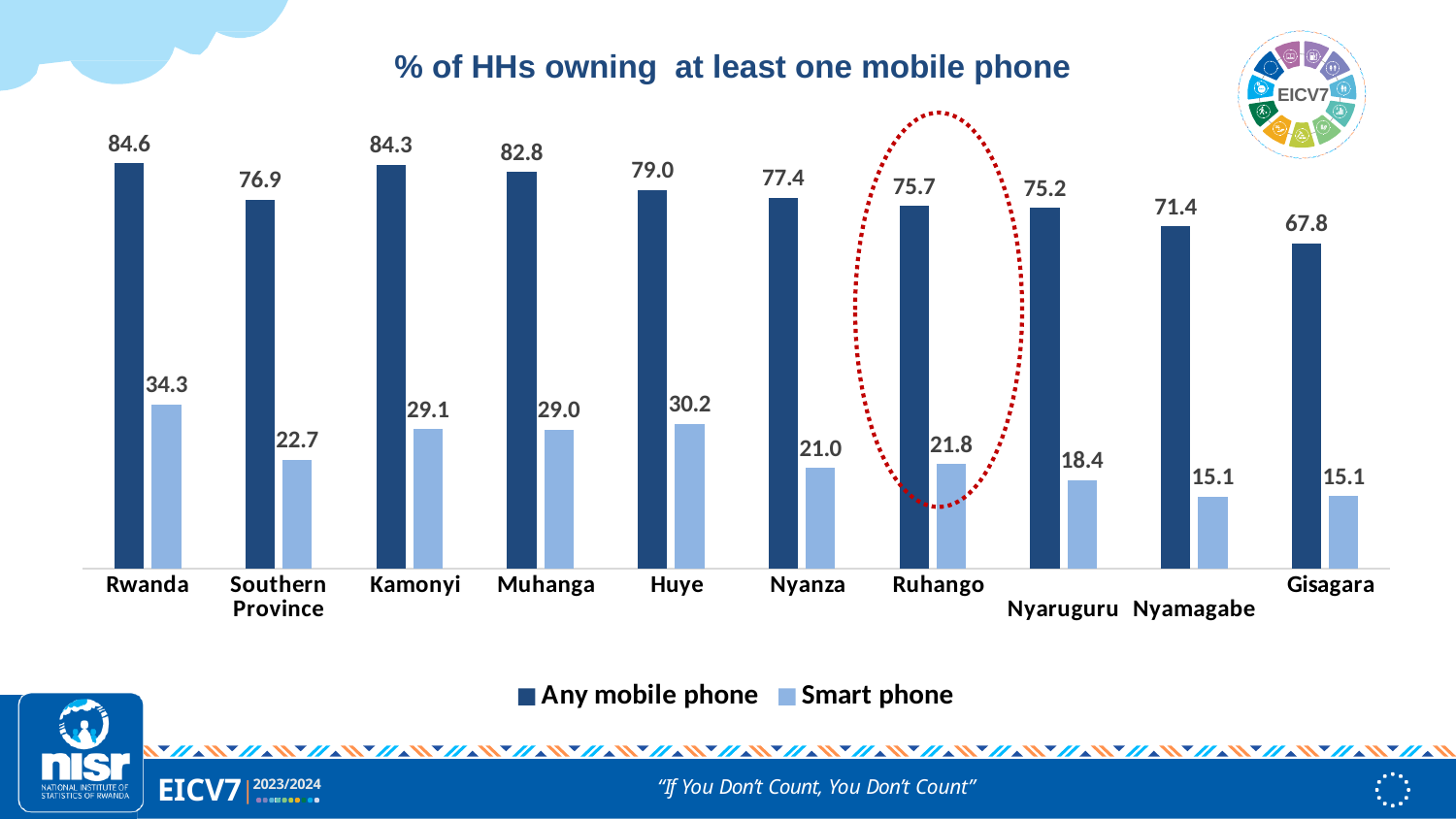
How many categories are shown on the x axis? 10 Which category has the highest Smart phone value? Rwanda What is the Smart phone value for Huye? 30.2 What is the value for Any mobile phone in Rwanda? 84.6 Which district is highlighted with a red dotted circle? Ruhango How many series does the legend list? 2 Which category has the lowest Any mobile phone value? Gisagara What is the difference between the Any mobile phone values for Ruhango and Gisagara? 7.9 What is the Any mobile phone value for Nyaruguru? 75.2 What is the Smart phone value for Southern Province? 22.7 What is the difference between the Any mobile phone and Smart phone values for Rwanda? 50.3 Which has the larger Smart phone value, Huye or Muhanga? Huye